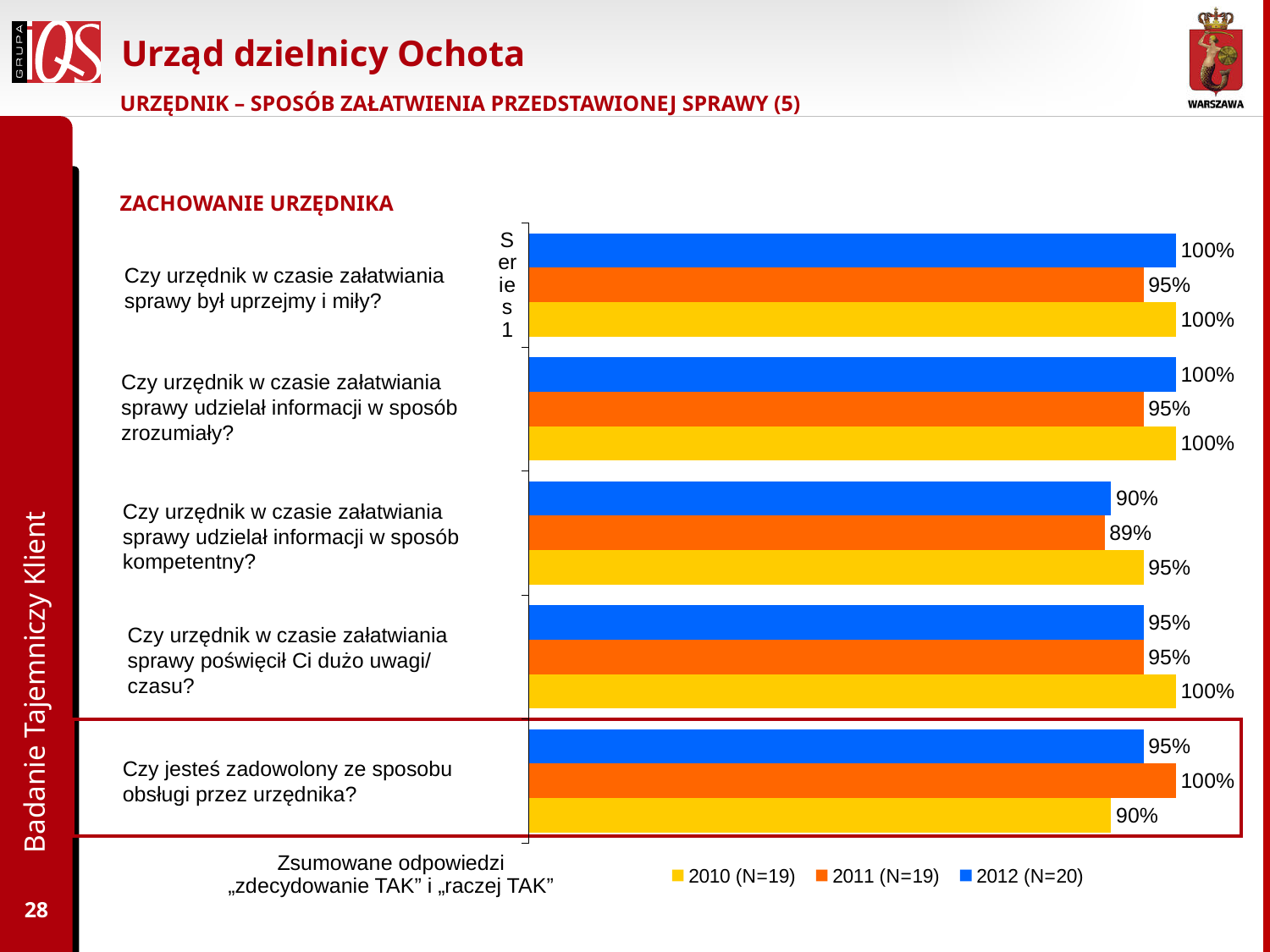
What is the 2011 (N=19) value for "Czy jesteś zadowolony ze sposobu obsługi przez urzędnika?"? 100% What is the 2010 (N=19) value for "Czy urzędnik w czasie załatwiania sprawy udzielał informacji w sposób kompetentny?"? 95% How many question categories are plotted in the chart? 5 How many series does the legend list? 3 What is the difference between the 2011 and 2010 values for "Czy jesteś zadowolony ze sposobu obsługi przez urzędnika?"? 10% What kind of chart is shown on the slide? bar chart Which colour represents the 2012 (N=20) series in the chart? blue For "Czy urzędnik w czasie załatwiania sprawy udzielał informacji w sposób kompetentny?", which is larger: the 2012 value or the 2010 value? 2010 Which year has the lowest value for "Czy jesteś zadowolony ze sposobu obsługi przez urzędnika?"? 2010 (N=19) What is the 2011 (N=19) value for "Czy urzędnik w czasie załatwiania sprawy udzielał informacji w sposób kompetentny?"? 89% What is the 2012 (N=20) value for "Czy jesteś zadowolony ze sposobu obsługi przez urzędnika?"? 95% What is the 2010 (N=19) value for "Czy urzędnik w czasie załatwiania sprawy poświęcił Ci dużo uwagi/ czasu?"? 100%